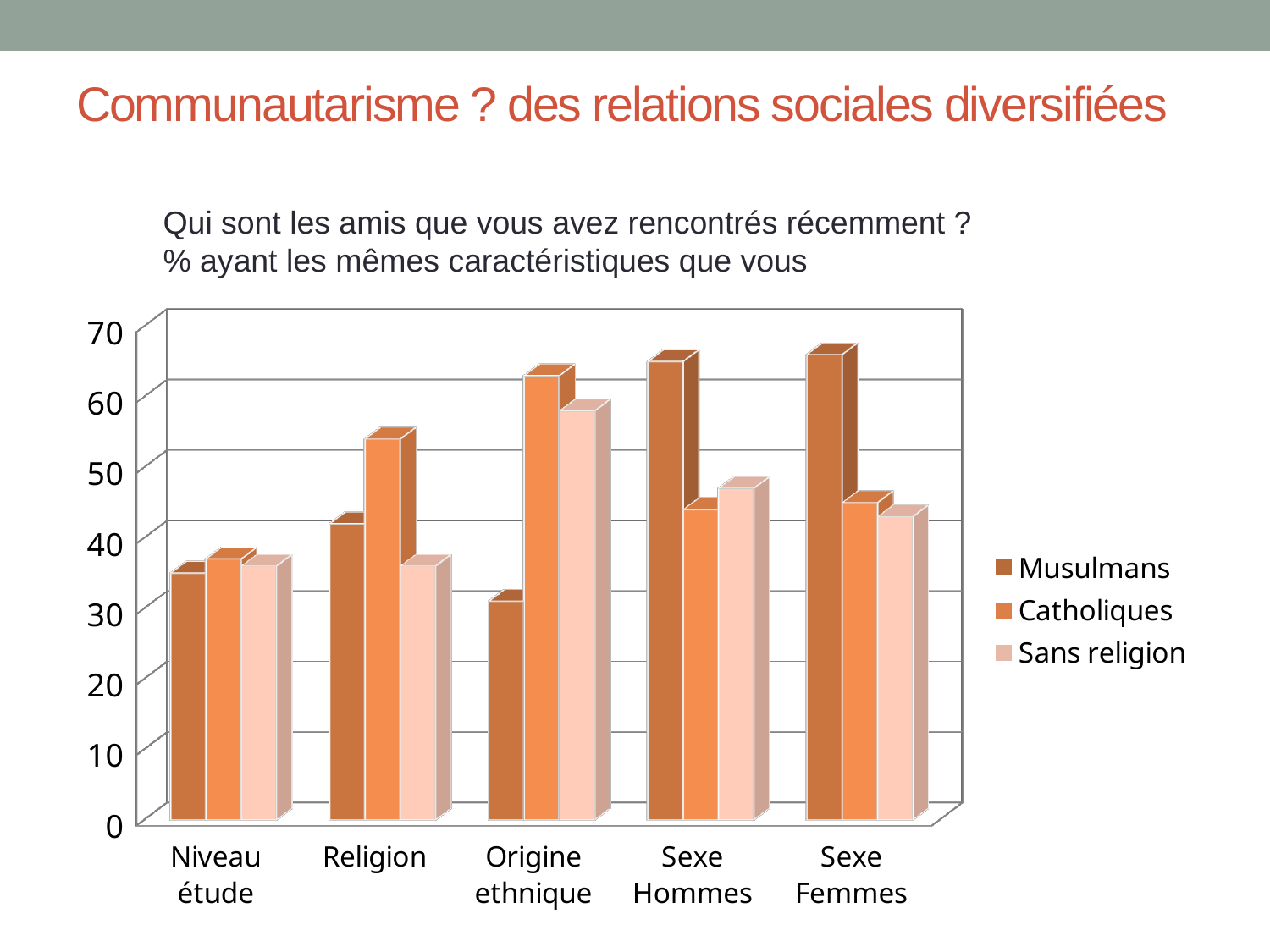
Is the value for Musulmans in the Sexe Hommes category greater or less than 60? greater How many categories are shown on the x axis of the chart? 5 Which series are listed in the chart's legend? Musulmans, Catholiques, Sans religion Is the value for Catholiques in the Origine ethnique category greater or less than 50? greater Is the value for Sans religion in the Religion category greater or less than 40? less For the Musulmans series, which category has the lowest value? Origine ethnique In the Religion category, which is larger: Musulmans or Catholiques? Catholiques How many series does the chart's legend list? 3 In the Origine ethnique category, which is larger: Musulmans or Sans religion? Sans religion In the Sexe Hommes category, which is larger: Musulmans or Catholiques? Musulmans What kind of chart is shown on the slide? bar chart